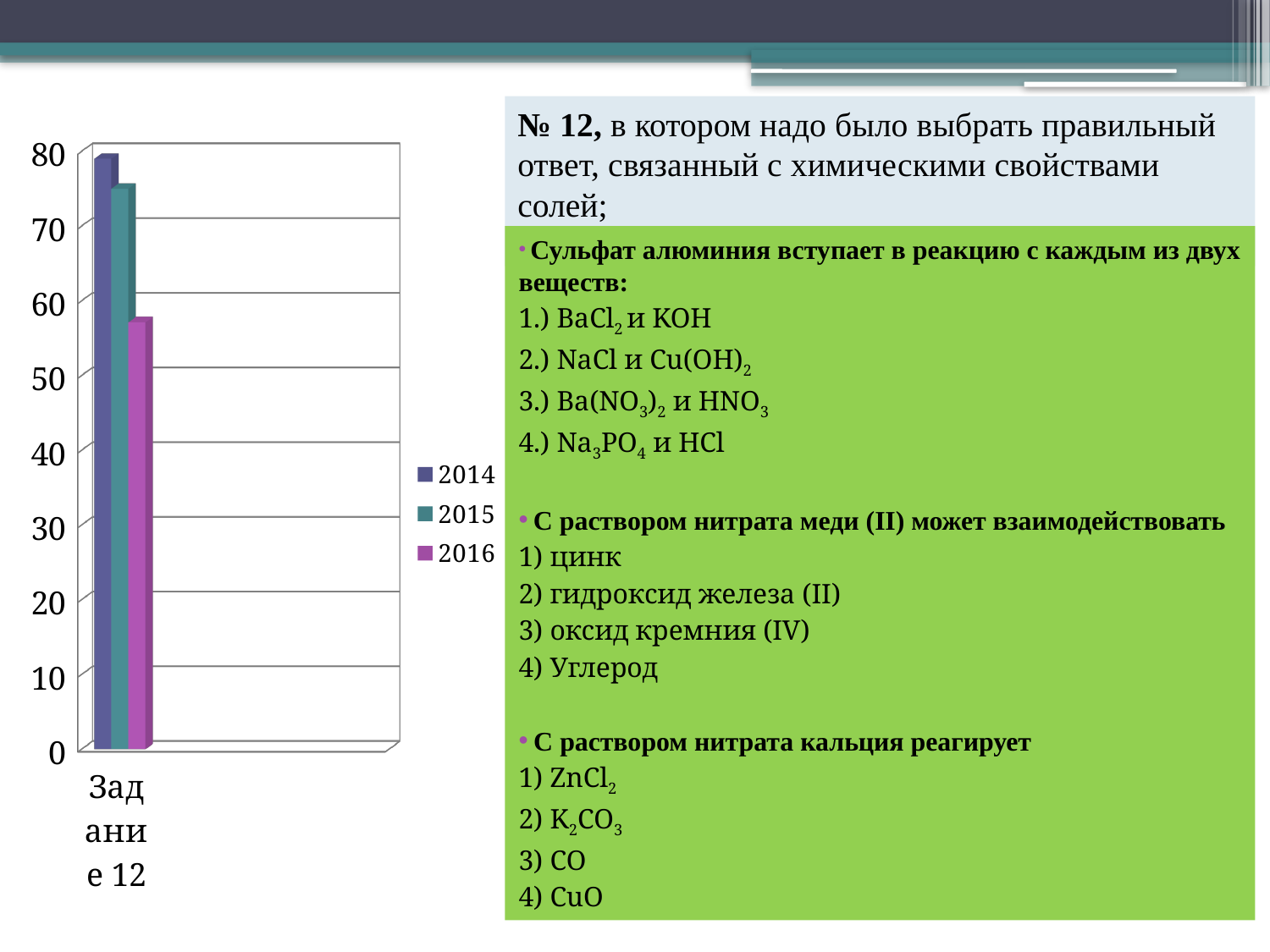
Which series has the highest value for Задание 12? 2014 Which is larger for Задание 12, the value for 2015 or the value for 2016? 2015 How many categories are shown on the x axis of the chart? 1 Which series has the lowest value for Задание 12? 2016 Is the value for 2014 greater or less than 70? greater Is the value for 2016 greater or less than 50? greater How many series does the chart legend list? 3 What is the category label shown on the x axis of the chart? Задание 12 Is the value for 2016 greater or less than 60? less Which is larger for Задание 12, the value for 2014 or the value for 2015? 2014 What kind of chart is shown on the slide? bar chart